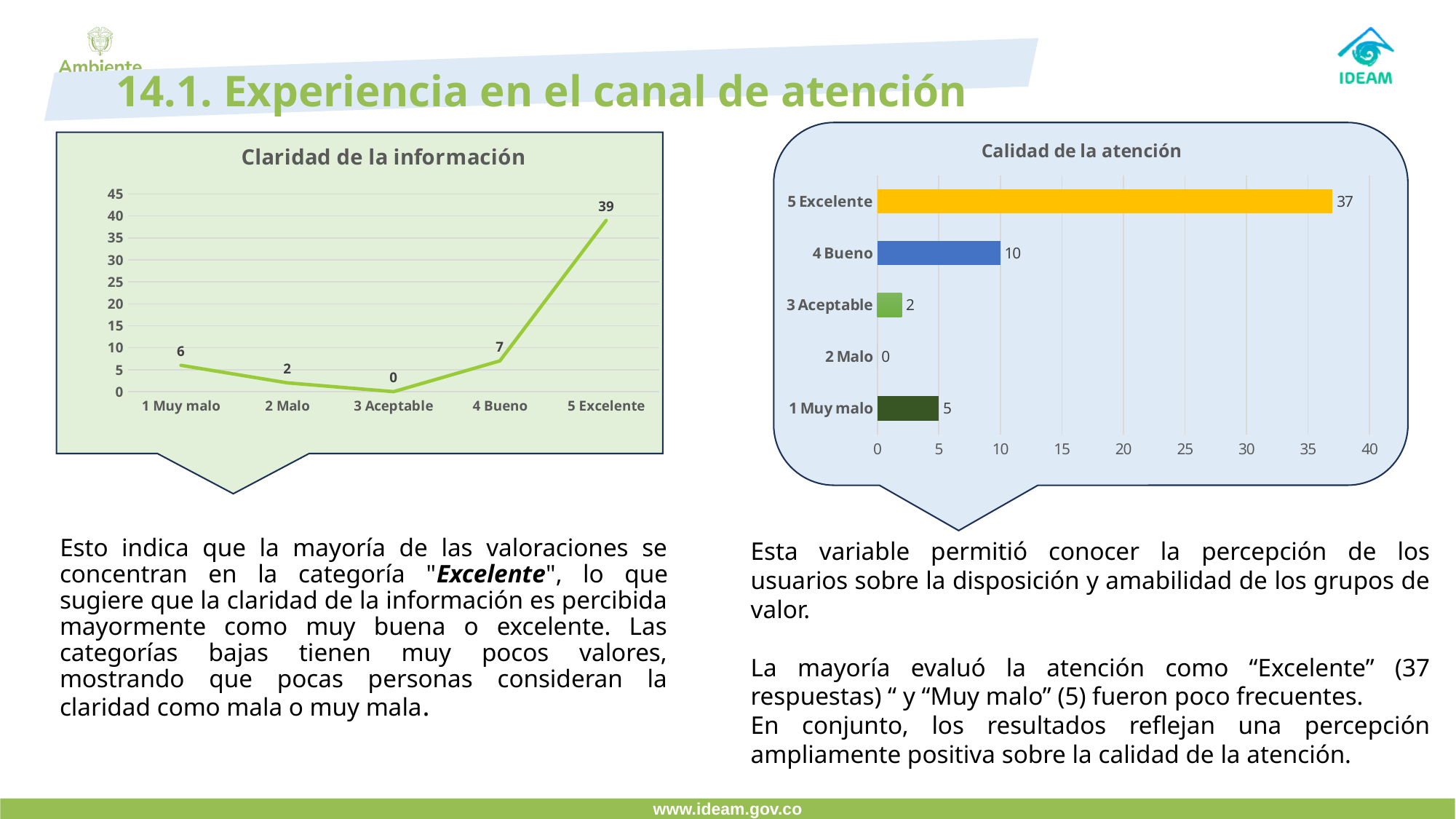
What kind of chart is 'Claridad de la información'? Line chart In the 'Calidad de la atención' chart, what is the value for 2 Malo? 0 How many categories are shown on the x axis of the 'Claridad de la información' chart? 5 In the 'Calidad de la atención' chart, which is larger, the value for 1 Muy malo or the value for 3 Aceptable? 1 Muy malo In the 'Claridad de la información' chart, what is the difference between the values for 5 Excelente and 4 Bueno? 32 In the 'Calidad de la atención' chart, what colour is the bar for 5 Excelente? Yellow In the 'Claridad de la información' chart, what is the value for 5 Excelente? 39 In the 'Claridad de la información' chart, what is the value for 1 Muy malo? 6 In the 'Calidad de la atención' chart, which category has the highest value? 5 Excelente What kind of chart is 'Calidad de la atención'? Bar chart In the 'Claridad de la información' chart, which category has the lowest value? 3 Aceptable In the 'Calidad de la atención' chart, what is the value for 4 Bueno? 10